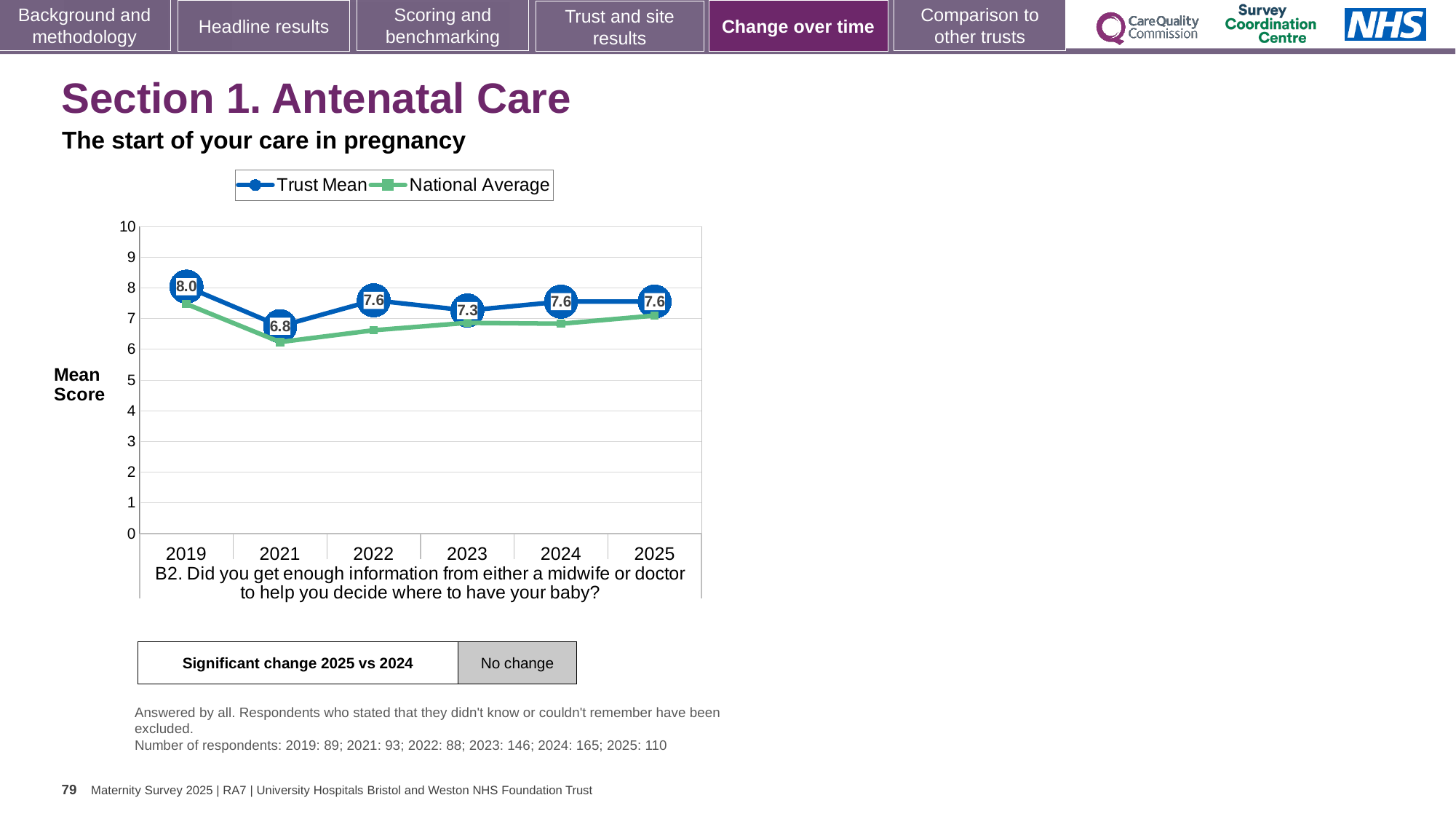
Is the National Average for 2021 greater or less than 7? less How many series does the legend list? 2 In which year is the Trust Mean highest? 2019 What is the Trust Mean for 2023? 7.3 In which year is the Trust Mean lowest? 2021 What is the Trust Mean for 2019? 8.0 What is the difference between the Trust Mean in 2019 and in 2021? 1.2 What is the Trust Mean for 2021? 6.8 What kind of chart is shown on the slide? line chart Which is larger, the Trust Mean in 2022 or in 2023? 2022 Does the Trust Mean rise or fall from 2019 to 2021? fall How many years are shown on the x axis? 6